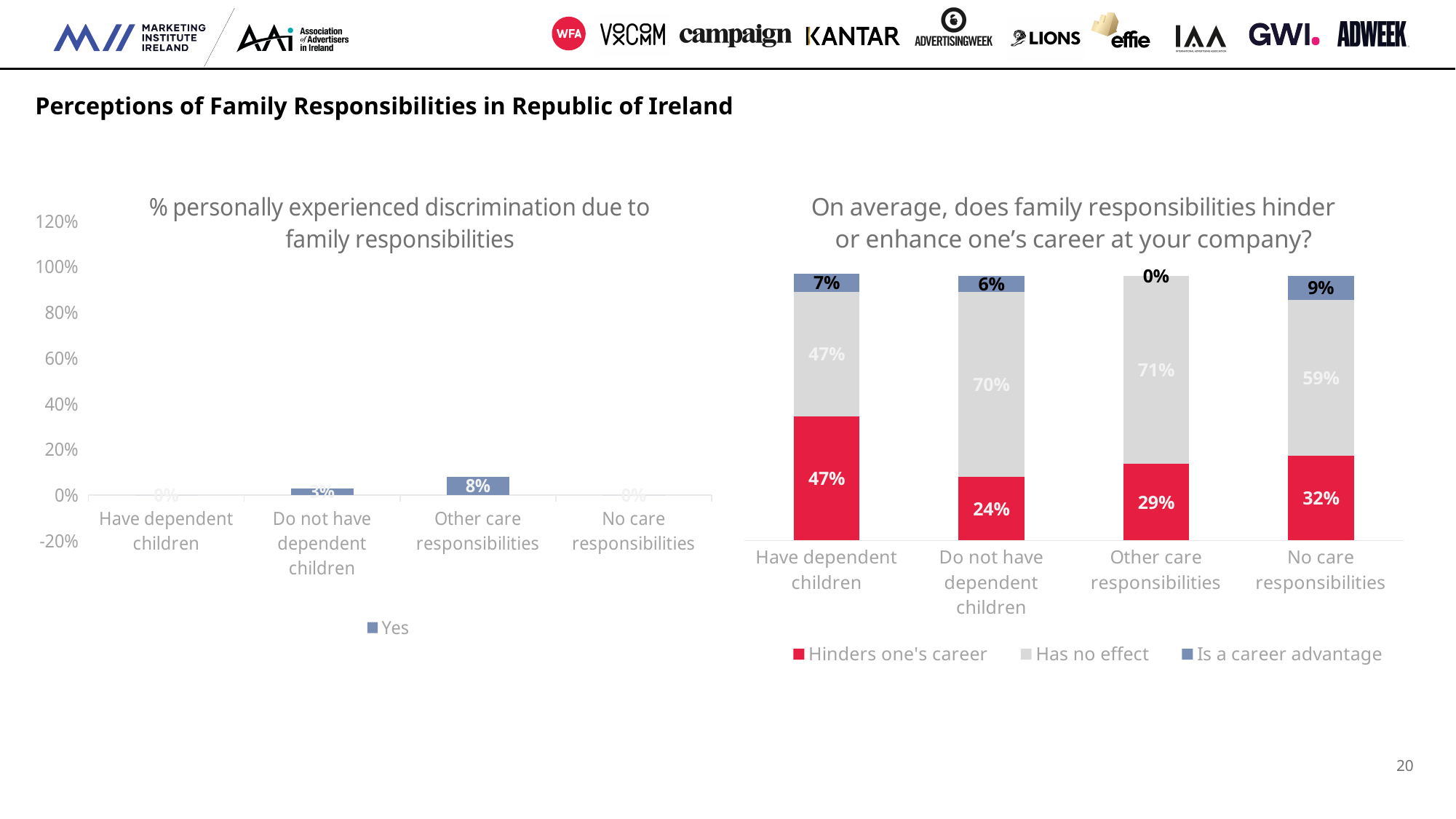
In the right chart, what percentage of respondents with other care responsibilities say family responsibilities have no effect on one's career? 71% In the right chart, what percentage of respondents with no care responsibilities say family responsibilities are a career advantage? 9% In the left chart, what series does the legend list? Yes In the right chart, what is the difference between the 'Hinders one's career' values for 'Have dependent children' and 'Do not have dependent children'? 23% In the left chart, which category has the highest percentage of respondents who experienced discrimination? Other care responsibilities In the right chart, how many series does the legend list? 3 In the left chart, what percentage of respondents with other care responsibilities personally experienced discrimination due to family responsibilities? 8% In the right chart, what percentage of respondents who have dependent children say family responsibilities hinder one's career? 47% In the right chart, which category has the lowest 'Hinders one's career' value? Do not have dependent children In the left chart, how many categories are shown on the x axis? 4 In the right chart, which is larger: the 'Has no effect' value for 'Do not have dependent children' or for 'No care responsibilities'? Do not have dependent children What type of chart is the right chart? Stacked bar chart